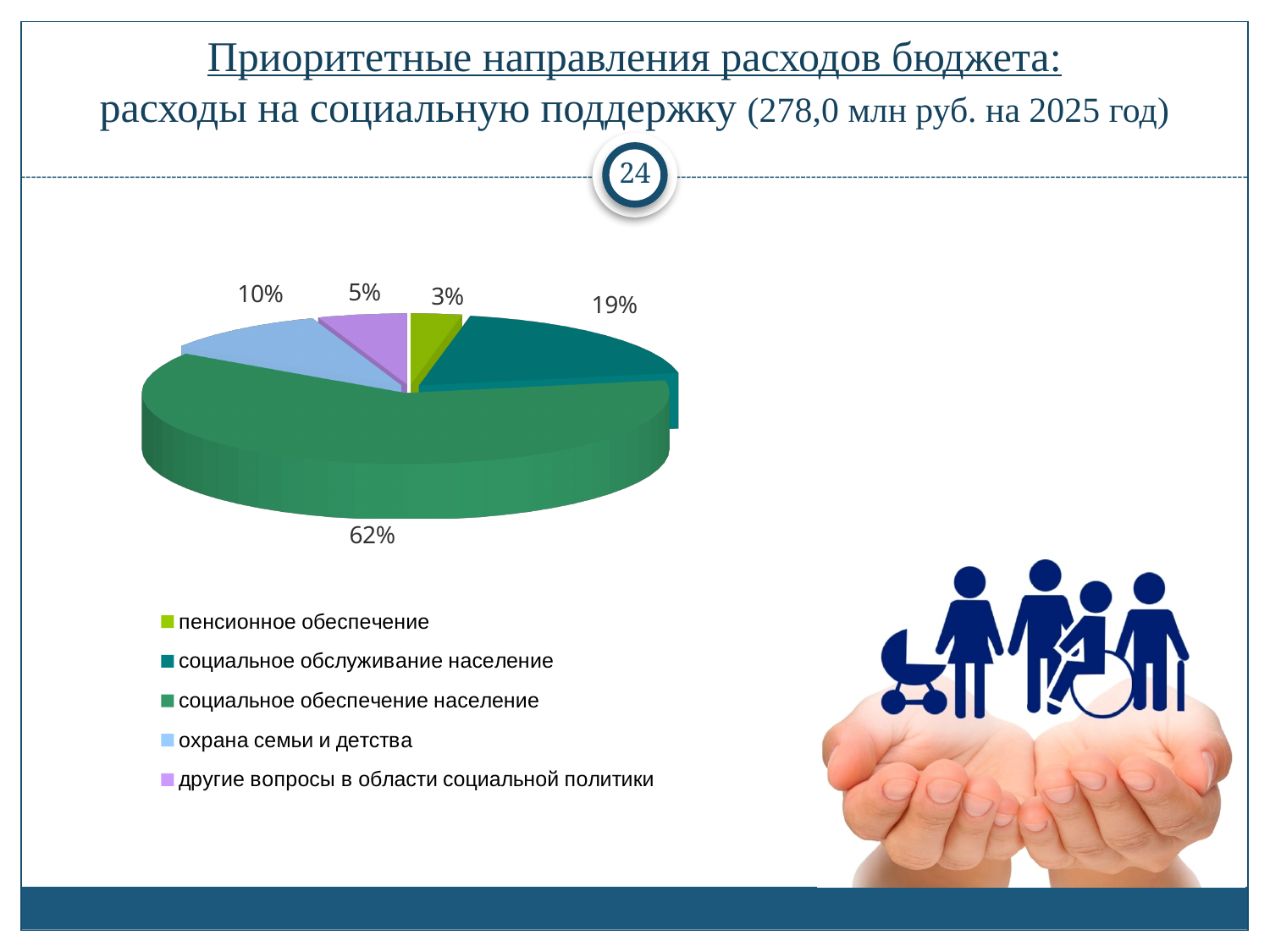
Which category has the largest share of the pie? социальное обеспечение население What share of the pie does социальное обеспечение население have? 62% What kind of chart is shown on the slide? pie chart What share of the pie does социальное обслуживание население have? 19% Which category has the smallest share of the pie? пенсионное обеспечение What is the difference in percentage points between социальное обеспечение население and социальное обслуживание население? 43 What total amount of social support spending for 2025 is stated in the slide title? 278,0 млн руб. Which is larger: the share for охрана семьи и детства or the share for другие вопросы в области социальной политики? охрана семьи и детства How many categories does the pie chart have? 5 What share of the pie does пенсионное обеспечение have? 3%